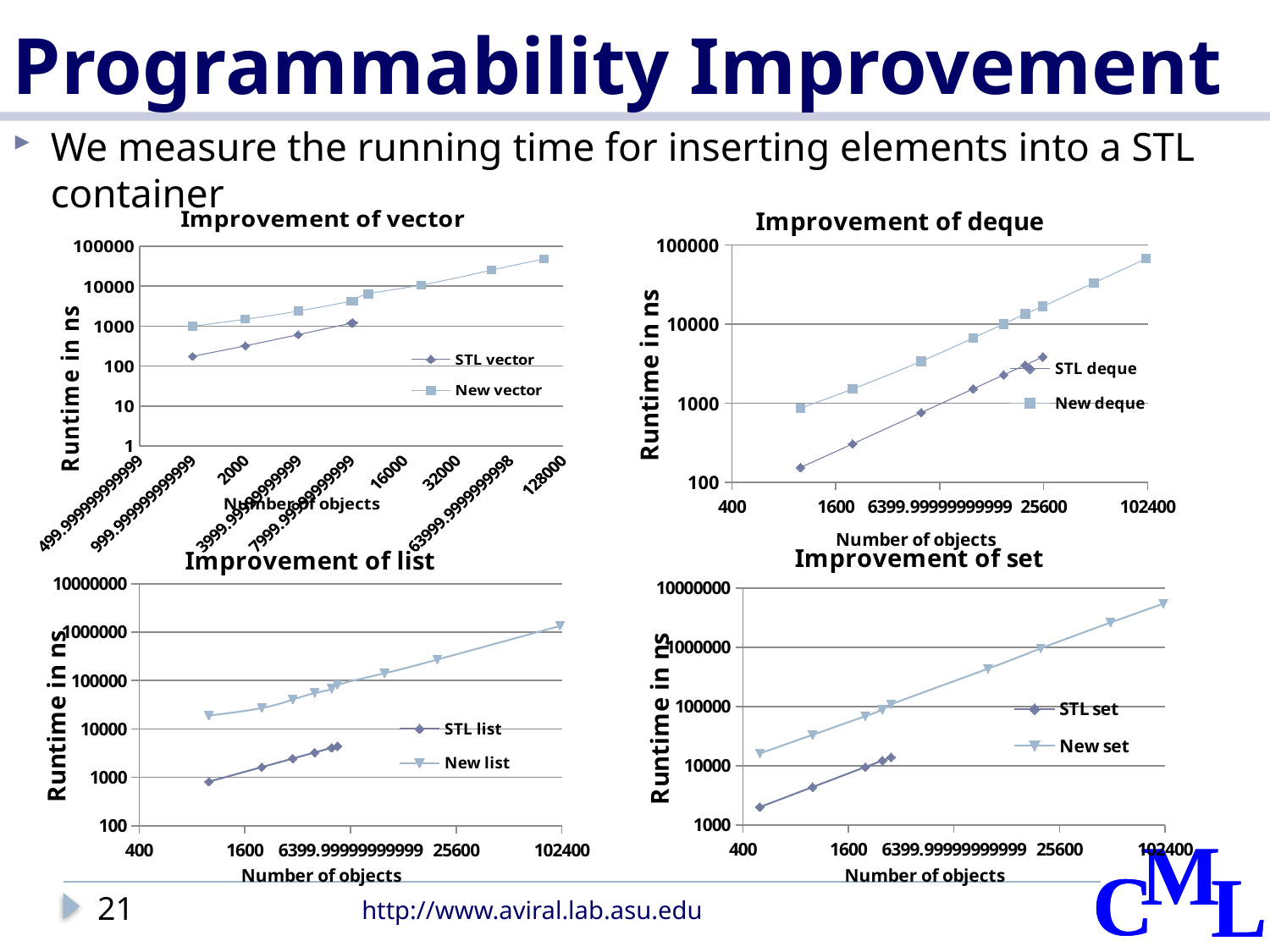
In the 'Improvement of set' chart, is the runtime of the STL set series at its first plotted point greater or less than 1000? greater In the 'Improvement of vector' chart, how many data points are plotted for the STL vector series? 5 In the 'Improvement of list' chart, which series has the lower runtime at 1600 objects, STL list or New list? STL list In the 'Improvement of vector' chart, is the runtime of the New vector series at 128000 objects greater or less than 10000? greater What kind of chart is the 'Improvement of vector' chart? line chart In the 'Improvement of list' chart, what are the two series named in the legend? STL list and New list In the 'Improvement of vector' chart, how many data points are plotted for the New vector series? 9 In the 'Improvement of set' chart, does the runtime of the New set series rise or fall as the number of objects increases? rise In the 'Improvement of list' chart, is the runtime of the New list series at 102400 objects greater or less than 1000000? greater What is the y-axis title of the 'Improvement of set' chart? Runtime in ns In the 'Improvement of deque' chart, which series has the higher runtime at 1600 objects, STL deque or New deque? New deque How many series does the legend of the 'Improvement of deque' chart list? 2